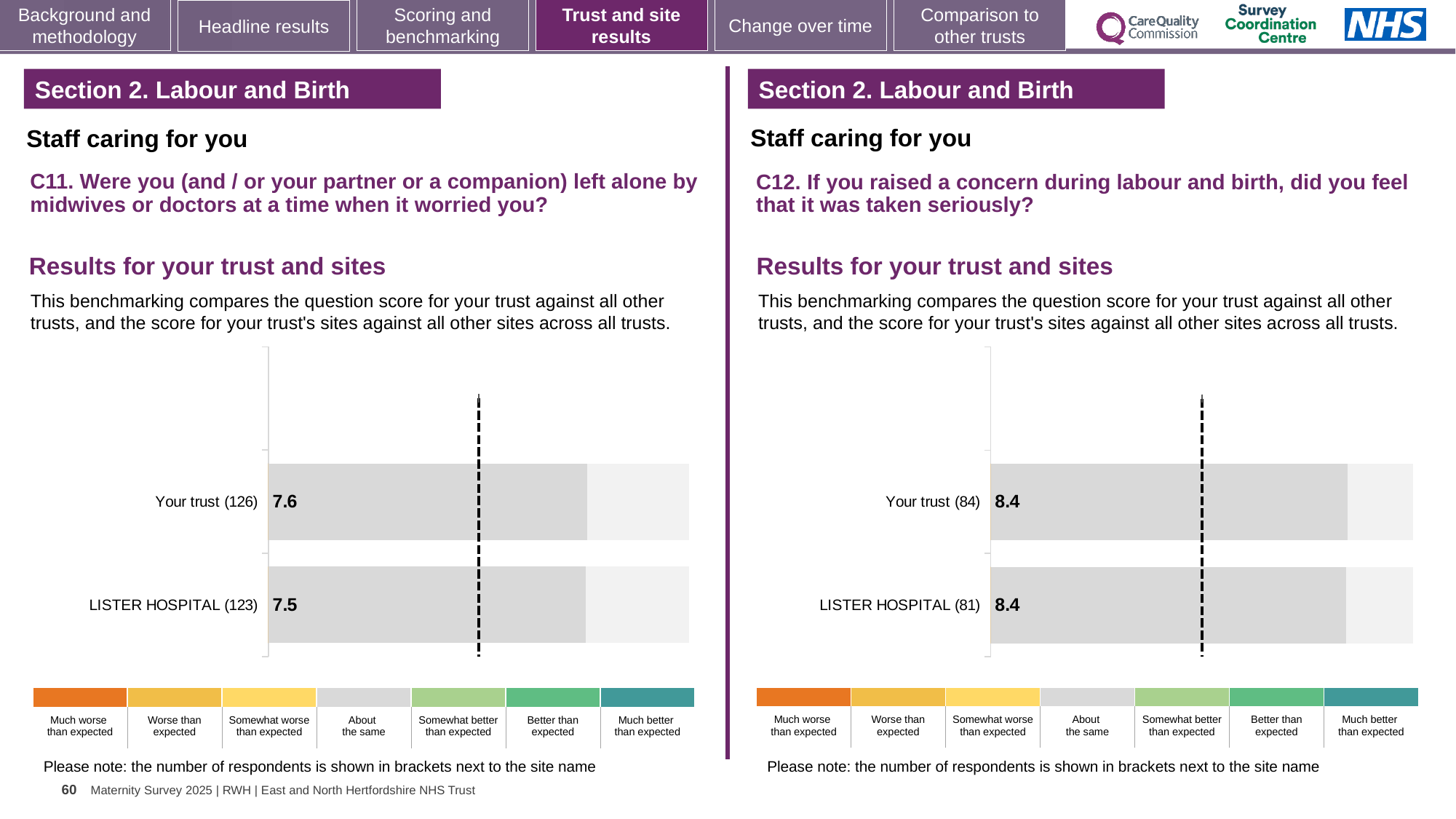
In the C11 chart on the left, what is the score for Your trust? 7.6 In the C12 chart on the right, how many respondents are shown in brackets for LISTER HOSPITAL? 81 In the C11 chart on the left, how many respondents are shown in brackets for Your trust? 126 In the C11 chart on the left, what is the difference between the Your trust score and the LISTER HOSPITAL score? 0.1 How many bars are plotted in the C12 chart on the right? 2 In the C12 chart on the right, what is the score for Your trust? 8.4 In the C12 chart on the right, what is the score for LISTER HOSPITAL? 8.4 What kind of chart is used for the C11 results on the left? Bar chart In the C11 chart on the left, which has the higher score, Your trust or LISTER HOSPITAL? Your trust In the C11 chart on the left, what is the score for LISTER HOSPITAL? 7.5 In the C12 chart on the right, is the score for Your trust the same as the score for LISTER HOSPITAL? Yes